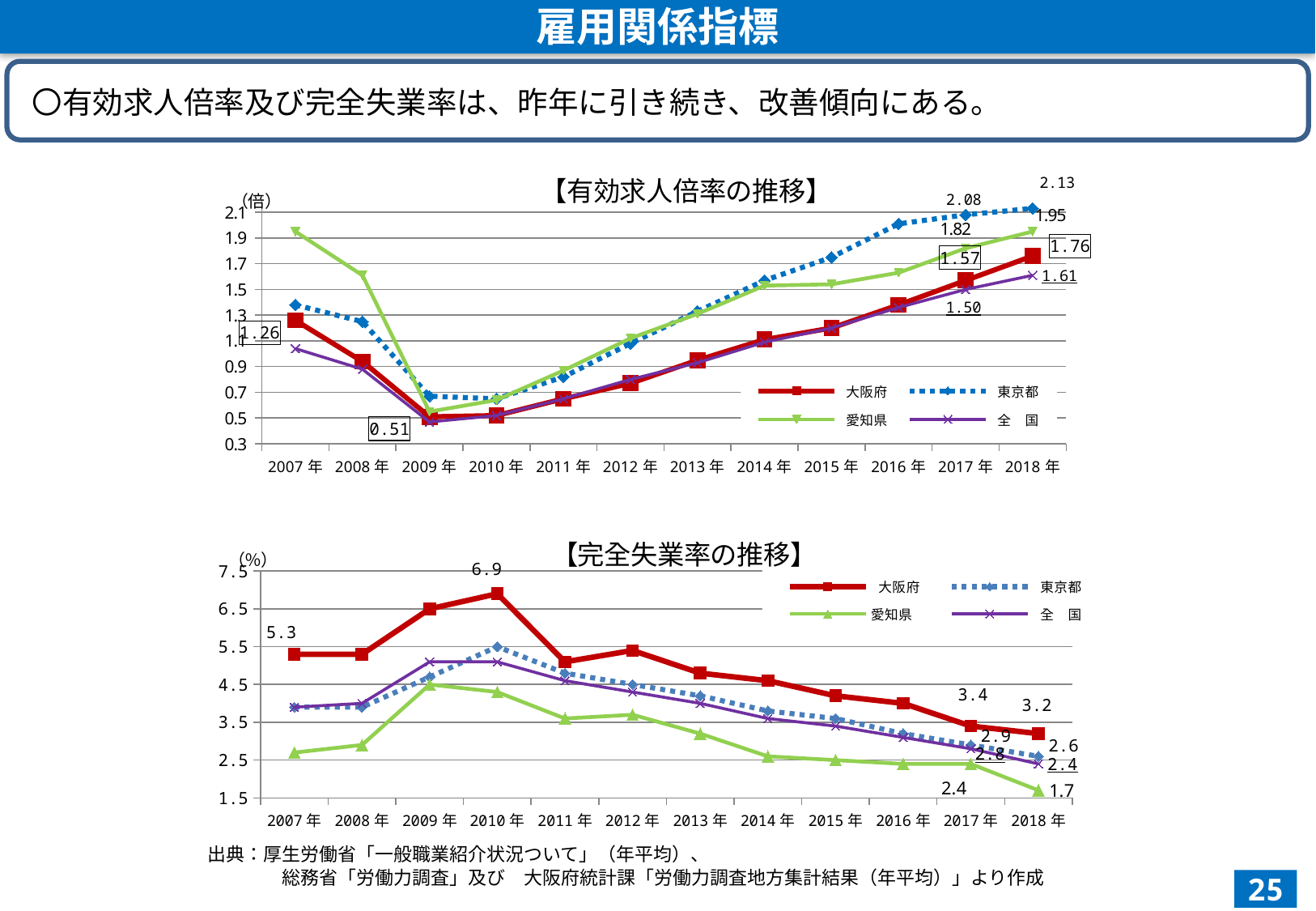
In the 【完全失業率の推移】 chart, what is the value for 大阪府 in 2010年? 6.9 In the 【完全失業率の推移】 chart, what is the value for 愛知県 in 2018年? 1.7 In the 【有効求人倍率の推移】 chart, what is the difference between the 大阪府 values for 2018年 and 2017年? 0.19 In the 【有効求人倍率の推移】 chart, how many series does the legend list? 4 In the 【完全失業率の推移】 chart, how many years are shown on the x axis? 12 In the 【有効求人倍率の推移】 chart, what is the value for 大阪府 in 2018年? 1.76 In the 【有効求人倍率の推移】 chart, what is the value for 大阪府 in 2009年? 0.51 What kind of chart is the 【完全失業率の推移】 chart? line chart In the 【有効求人倍率の推移】 chart, what is the value for 東京都 in 2018年? 2.13 In the 【完全失業率の推移】 chart, which series has the lowest value in 2018年? 愛知県 In the 【有効求人倍率の推移】 chart, is the value for 愛知県 in 2007年 greater or less than 1.7? greater In the 【有効求人倍率の推移】 chart, which series has the highest value in 2018年? 東京都